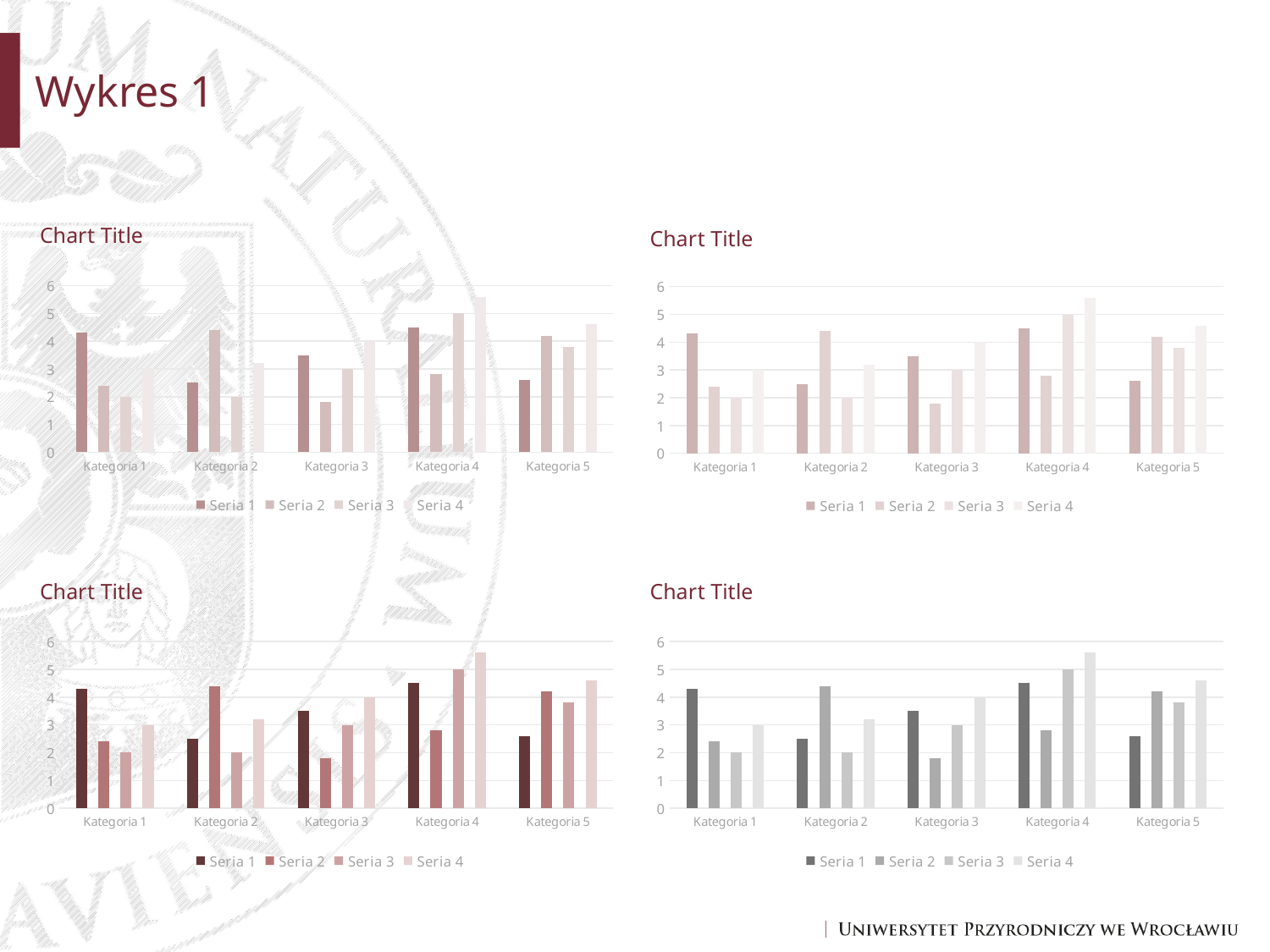
On the top-right chart, which category has the lowest Seria 2 bar? Kategoria 3 On the top-left chart, what kind of chart is shown? bar chart What is the title of the bottom-right chart? Chart Title On the bottom-left chart, is the value of Seria 2 for Kategoria 3 greater or less than 2? less On the bottom-left chart, which is larger for Kategoria 5: Seria 1 or Seria 4? Seria 4 On the top-left chart, is the value of Seria 1 for Kategoria 1 greater or less than 4? greater On the bottom-right chart, is the value of Seria 4 for Kategoria 4 greater or less than 5? greater On the top-right chart, which is larger for Kategoria 2: Seria 1 or Seria 2? Seria 2 On the bottom-right chart, which category has the highest Seria 4 bar? Kategoria 4 On the top-right chart, how many series does the legend list? 4 On the bottom-left chart, how many categories are shown on the x axis? 5 On the top-left chart, what is the value of Seria 3 for Kategoria 4? 5